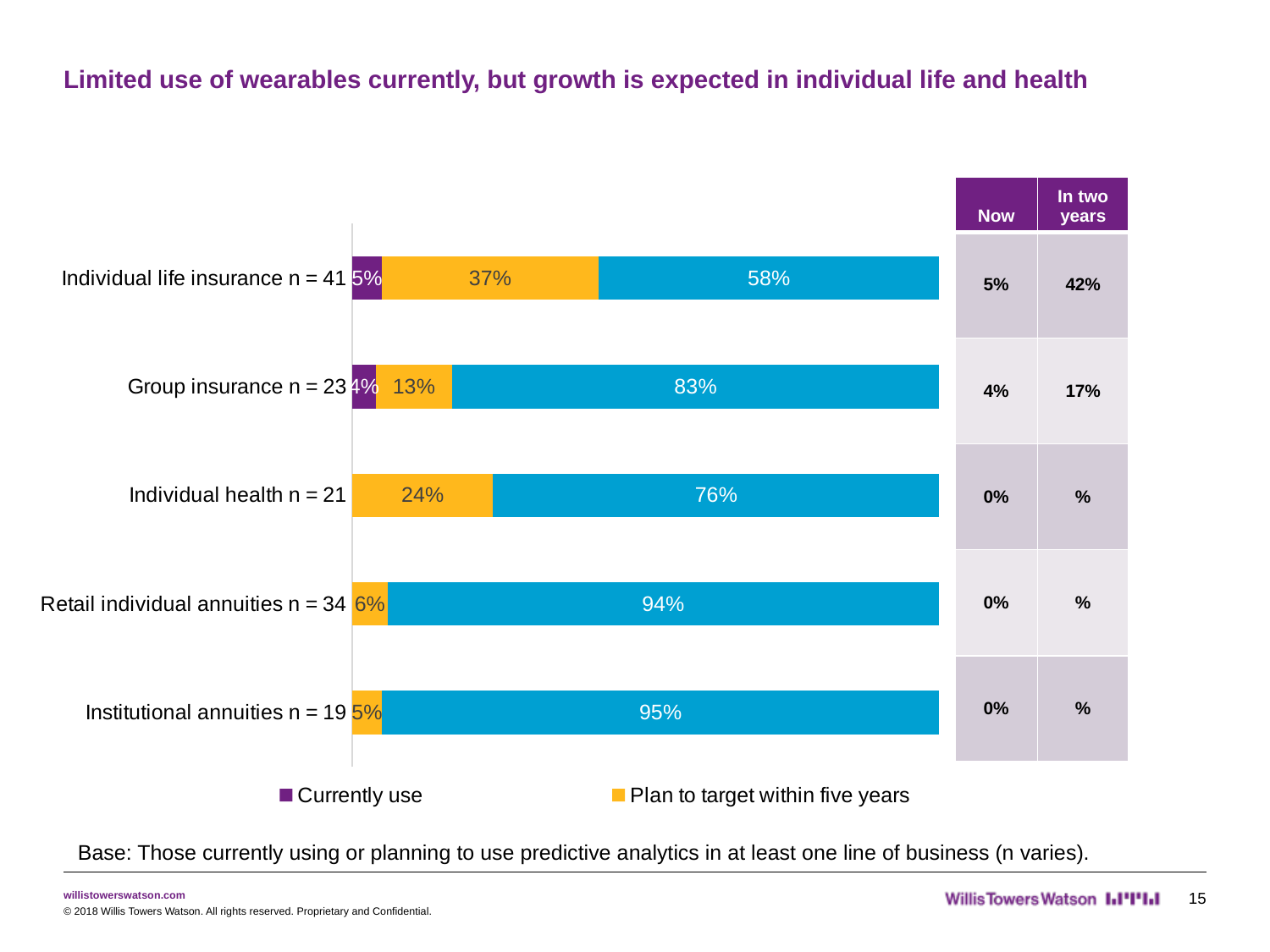
Which is larger: the 'Plan to target within five years' value for Individual health or for Group insurance? Individual health How many categories (lines of business) are plotted in the chart? 5 What is the 'Plan to target within five years' value for Individual health? 24% Which category has the lowest 'Plan to target within five years' value? Institutional annuities What kind of chart is shown on the slide? bar chart Which category has the highest 'Plan to target within five years' value? Individual life insurance What is the 'Currently use' value for Individual life insurance? 5% What is the difference between the 'Plan to target within five years' values for Individual life insurance and Group insurance? 24% What is the 'Plan to target within five years' value for Retail individual annuities? 6% What is the 'Currently use' value for Group insurance? 4% How many series does the chart legend list? 2 What is the 'Plan to target within five years' value for Individual life insurance? 37%